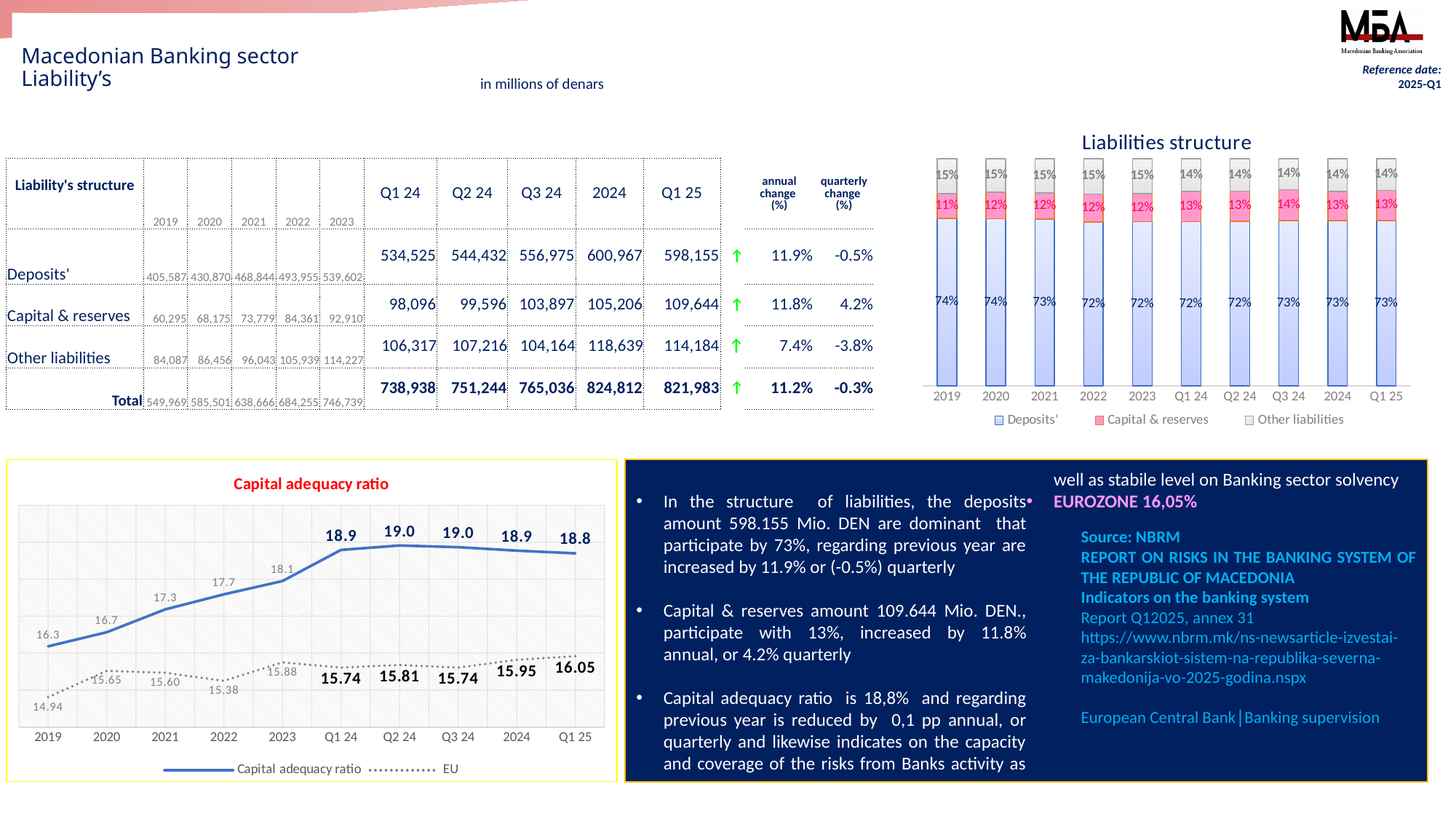
In the Capital adequacy ratio chart, which period has the lowest Capital adequacy ratio value? 2019 In the Liabilities structure chart, what share do Capital & reserves have in 2019? 11% In the Capital adequacy ratio chart, what is the Capital adequacy ratio value for Q1 25? 18.8 In the Capital adequacy ratio chart, what is the EU value for 2019? 14.94 How many series does the legend of the Liabilities structure chart list? 3 What kind of chart is the Liabilities structure chart? Stacked bar chart In the Liabilities structure chart, what share do Other liabilities have in 2024? 14% In the Capital adequacy ratio chart, what is the difference between the Capital adequacy ratio and the EU value in Q1 25? 2.75 In the Liabilities structure chart, what share do Deposits' have in Q1 25? 73% In the Capital adequacy ratio chart, is the Capital adequacy ratio or the EU value higher in 2023? Capital adequacy ratio How many periods are shown on the x axis of the Liabilities structure chart? 10 In the Capital adequacy ratio chart, does the Capital adequacy ratio rise or fall from 2019 to 2023? Rise